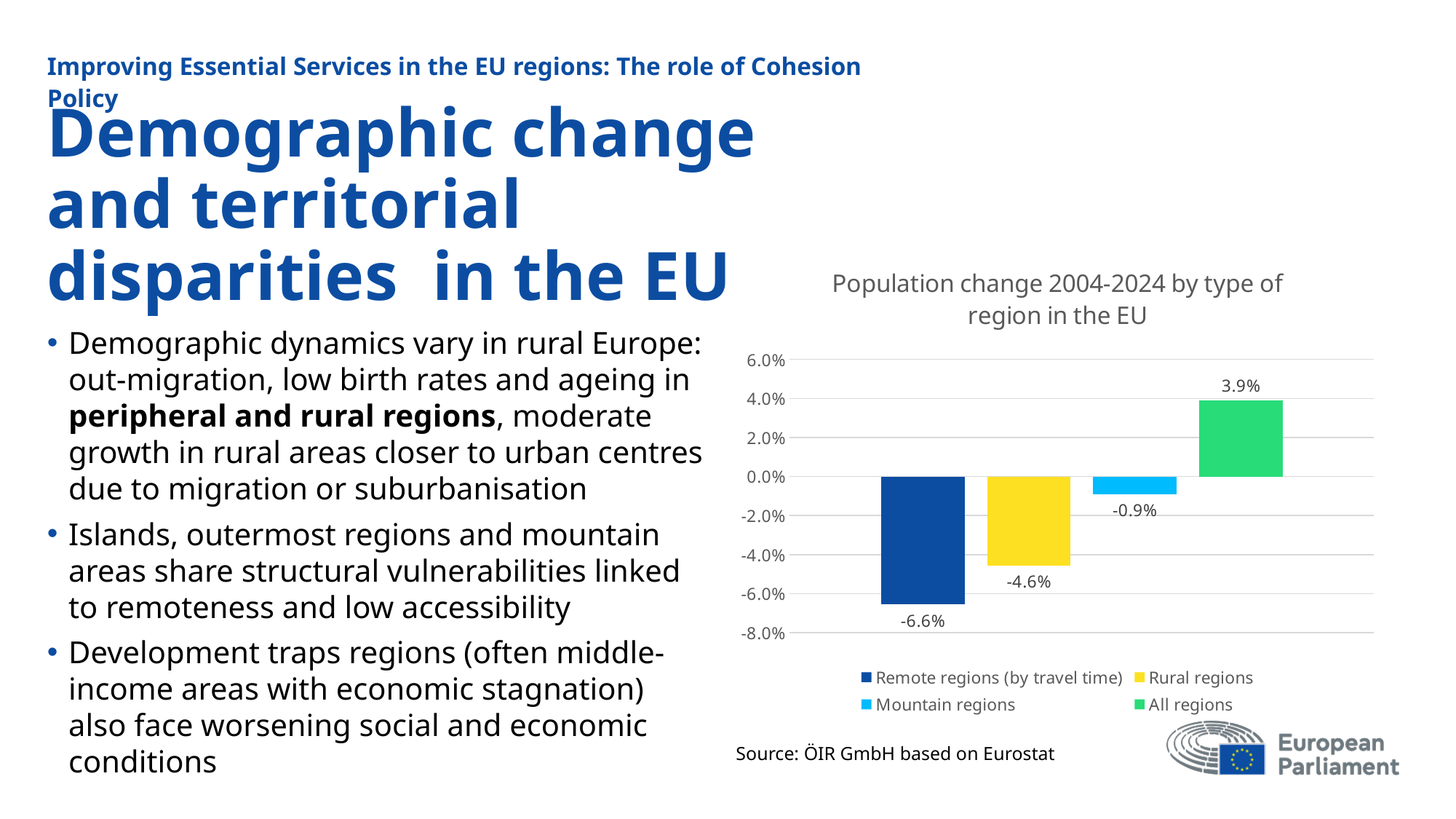
Which has a larger population change 2004-2024, Mountain regions or Rural regions? Mountain regions What is the population change 2004-2024 for All regions? 3.9% What is the population change 2004-2024 for Remote regions (by travel time)? -6.6% How many bars are plotted in the chart? 4 Is the population change for Remote regions (by travel time) greater or less than -6.0%? less How many entries does the chart legend list? 4 What is the difference between the population change for Rural regions and Remote regions (by travel time)? 2.0 percentage points Which type of region has the highest population change 2004-2024? All regions What is the population change 2004-2024 for Mountain regions? -0.9% What kind of chart is shown on the slide? Bar chart Which type of region has the lowest population change 2004-2024? Remote regions (by travel time) What is the population change 2004-2024 for Rural regions? -4.6%